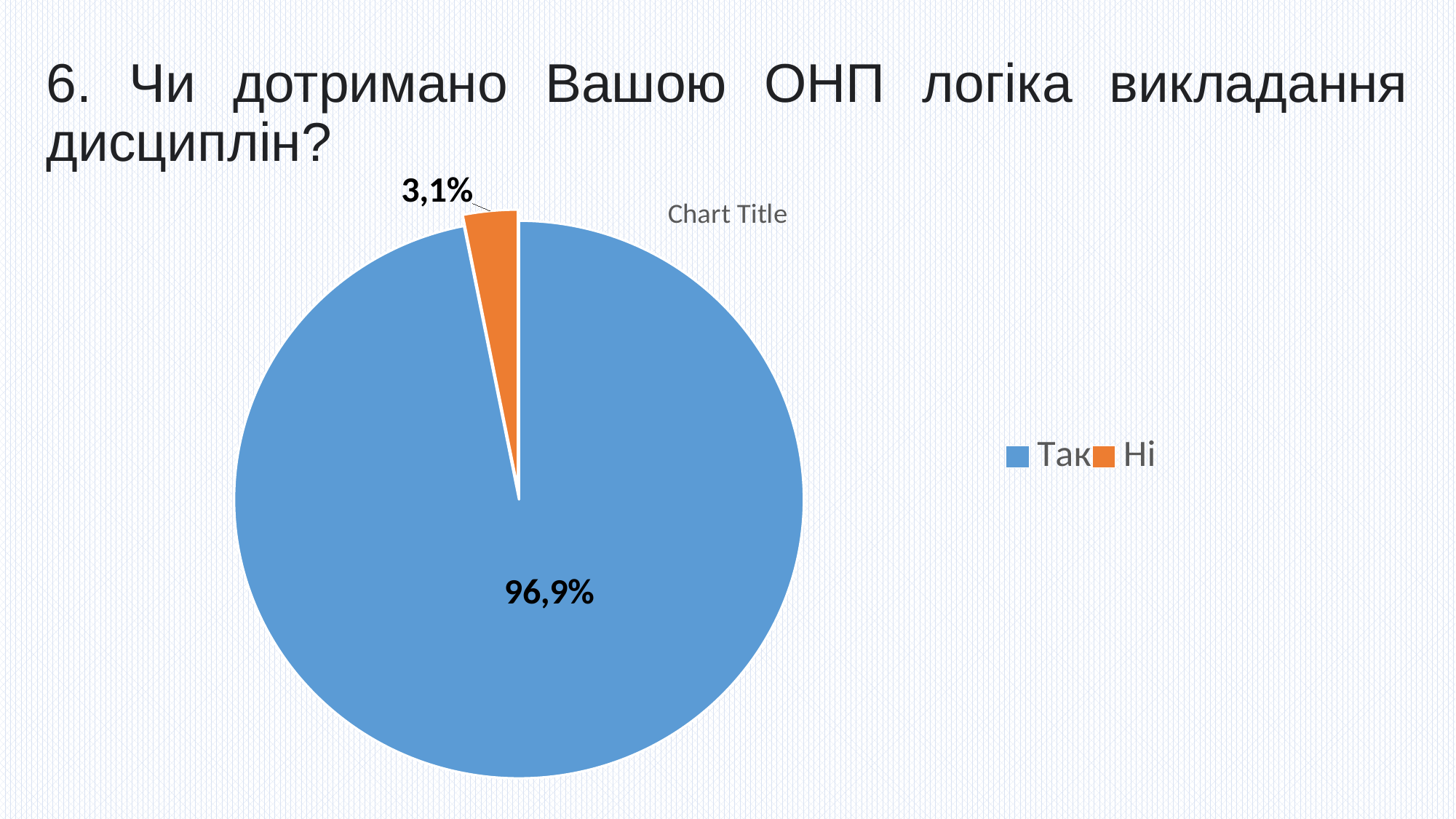
What share of the pie does the "Ні" slice represent? 3,1% What share of the pie does the "Так" slice represent? 96,9% How many slices does the pie chart have? 2 Which is larger, the share for "Так" or the share for "Ні"? Так What is the difference between the "Так" share and the "Ні" share? 93,8% Which category has the largest slice of the pie? Так What is the title shown on the chart? Chart Title What kind of chart is shown on the slide? pie chart How many entries does the legend list? 2 What colour is the "Ні" slice? orange Which category has the smallest slice of the pie? Ні